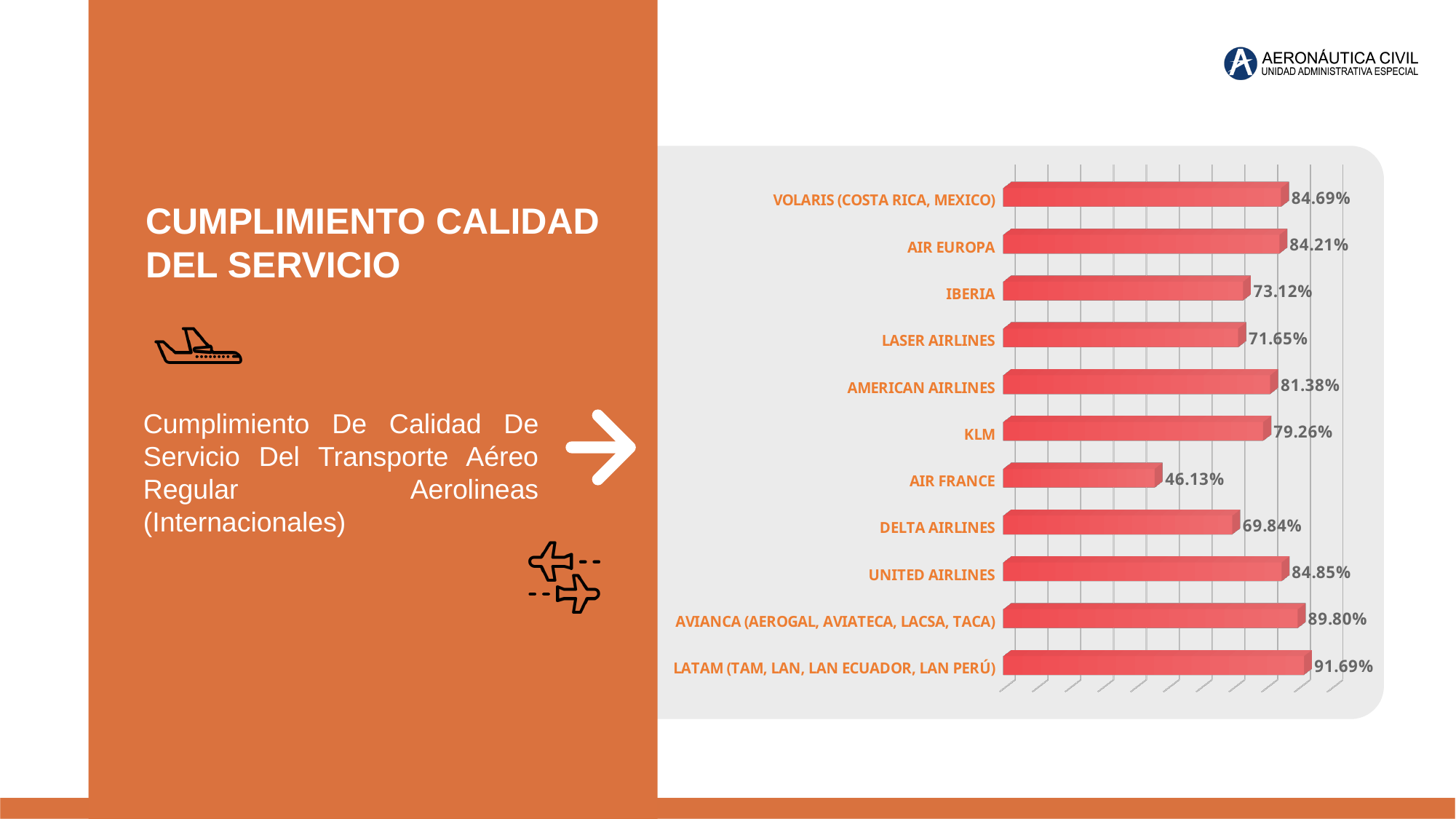
What colour are the bars in the chart? Red Which airline has the highest value? LATAM (TAM, LAN, LAN ECUADOR, LAN PERÚ) What is the value for AIR FRANCE? 46.13% Which airline has the lowest value? AIR FRANCE How many airlines are shown in the chart? 11 Which is larger, the value for AMERICAN AIRLINES or the value for LASER AIRLINES? AMERICAN AIRLINES What is the difference between the values for UNITED AIRLINES and DELTA AIRLINES? 15.01% What is the value for IBERIA? 73.12% What is the difference between the values for LATAM (TAM, LAN, LAN ECUADOR, LAN PERÚ) and AIR FRANCE? 45.56% What is the value for KLM? 79.26% What kind of chart is shown on the slide? Bar chart What is the value for AVIANCA (AEROGAL, AVIATECA, LACSA, TACA)? 89.80%